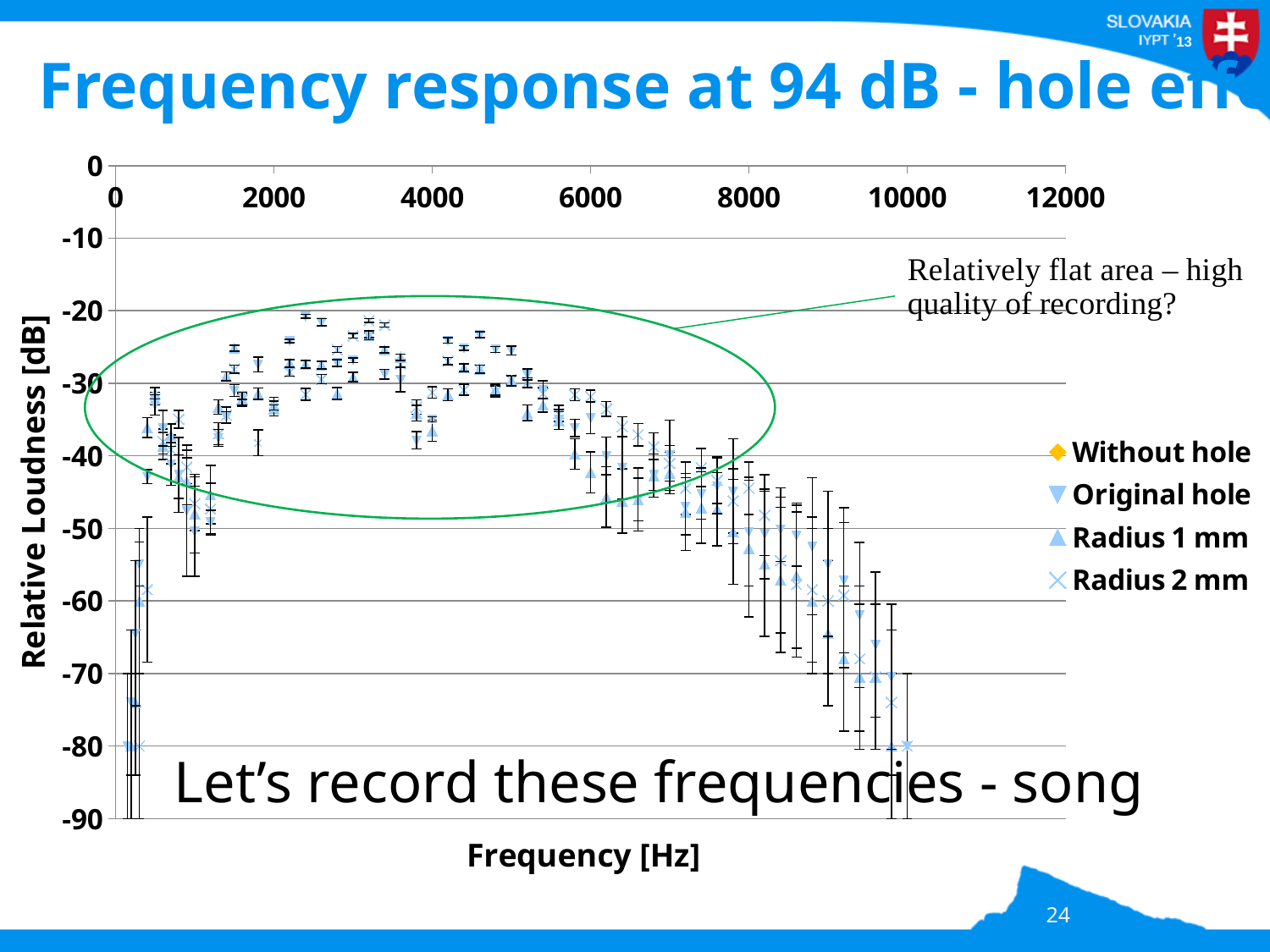
Do the plotted loudness values rise or fall as frequency increases from 6000 Hz to 10000 Hz? fall What is the highest tick value shown on the horizontal axis? 12000 How many series does the legend list? 4 What is the label of the vertical axis? Relative Loudness [dB] What kind of chart is shown on the slide? scatter chart What is the label of the horizontal axis? Frequency [Hz] Are the plotted values near 10000 Hz greater or less than -60 dB? less What does the annotation next to the green ellipse say? Relatively flat area – high quality of recording? What are the four series named in the legend? Without hole, Original hole, Radius 1 mm, Radius 2 mm Which frequency region has the higher plotted loudness values: around 2500 Hz or around 9000 Hz? around 2500 Hz Are the plotted values between 2000 Hz and 3000 Hz greater or less than -40 dB? greater What is the lowest value shown on the vertical axis? -90